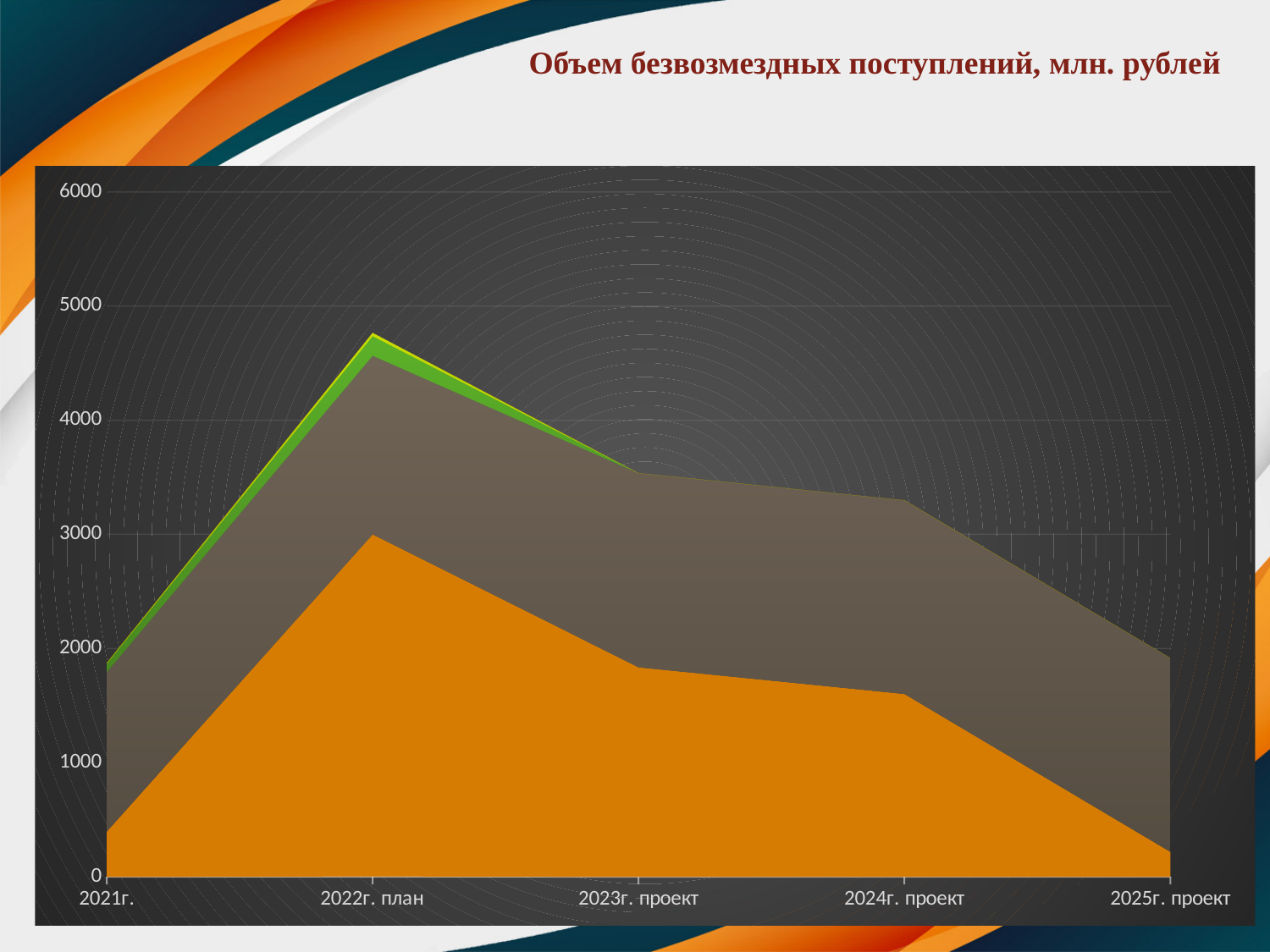
Is the value of the bottom (orange) series for 2024г. проект greater or less than 1000? greater What is the title of the chart? Объем безвозмездных поступлений, млн. рублей Is the value of the bottom (orange) series for 2023г. проект greater or less than 2000? less Which category has the highest value for the bottom (orange) series? 2022г. план How many categories are shown on the x axis? 5 Is the total stacked value for 2022г. план greater or less than 4000? greater Which is larger for the bottom (orange) series: 2023г. проект or 2024г. проект? 2023г. проект Does the bottom (orange) series rise or fall from 2022г. план to 2025г. проект? fall What kind of chart is shown on the slide? area chart Which category has the highest total stacked value? 2022г. план